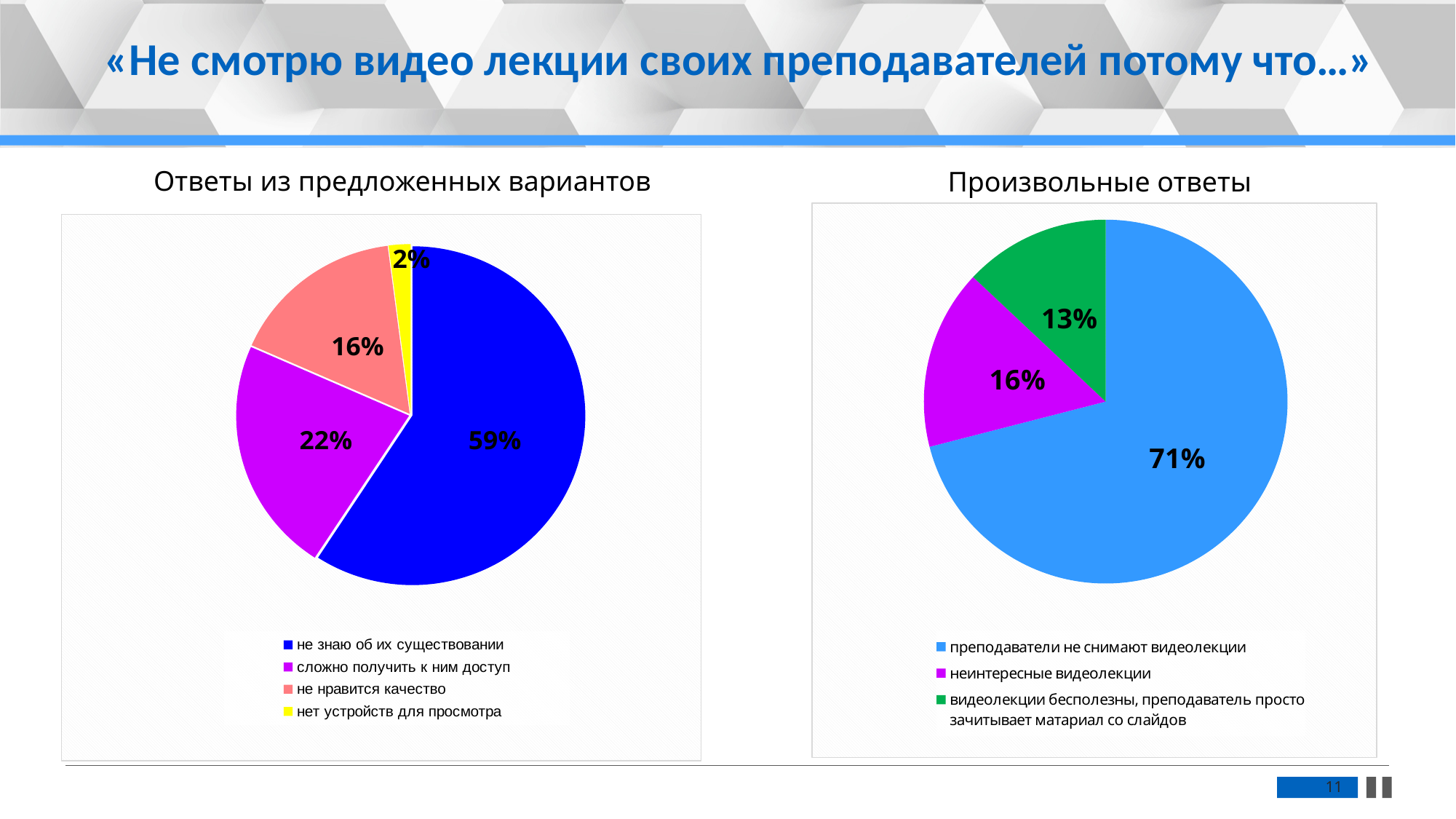
In the right chart 'Произвольные ответы', what colour is the slice for 'видеолекции бесполезны, преподаватель просто зачитывает матариал со слайдов'? green In the left chart 'Ответы из предложенных вариантов', which category has the smallest slice? нет устройств для просмотра In the right chart 'Произвольные ответы', what share is labelled for 'неинтересные видеолекции'? 16% In the left chart 'Ответы из предложенных вариантов', how many slices does the pie have? 4 In the left chart 'Ответы из предложенных вариантов', what is the difference in percentage points between 'сложно получить к ним доступ' and 'не нравится качество'? 6 In the left chart 'Ответы из предложенных вариантов', what share is labelled for 'нет устройств для просмотра'? 2% In the right chart 'Произвольные ответы', which category has the largest slice? преподаватели не снимают видеолекции In the right chart 'Произвольные ответы', which is larger: 'неинтересные видеолекции' or 'видеолекции бесполезны, преподаватель просто зачитывает матариал со слайдов'? неинтересные видеолекции In the left chart 'Ответы из предложенных вариантов', what share is labelled for 'сложно получить к ним доступ'? 22% In the left chart 'Ответы из предложенных вариантов', what share is labelled for 'не знаю об их существовании'? 59% In the right chart 'Произвольные ответы', what share is labelled for 'преподаватели не снимают видеолекции'? 71% What type of chart is the right chart 'Произвольные ответы'? pie chart